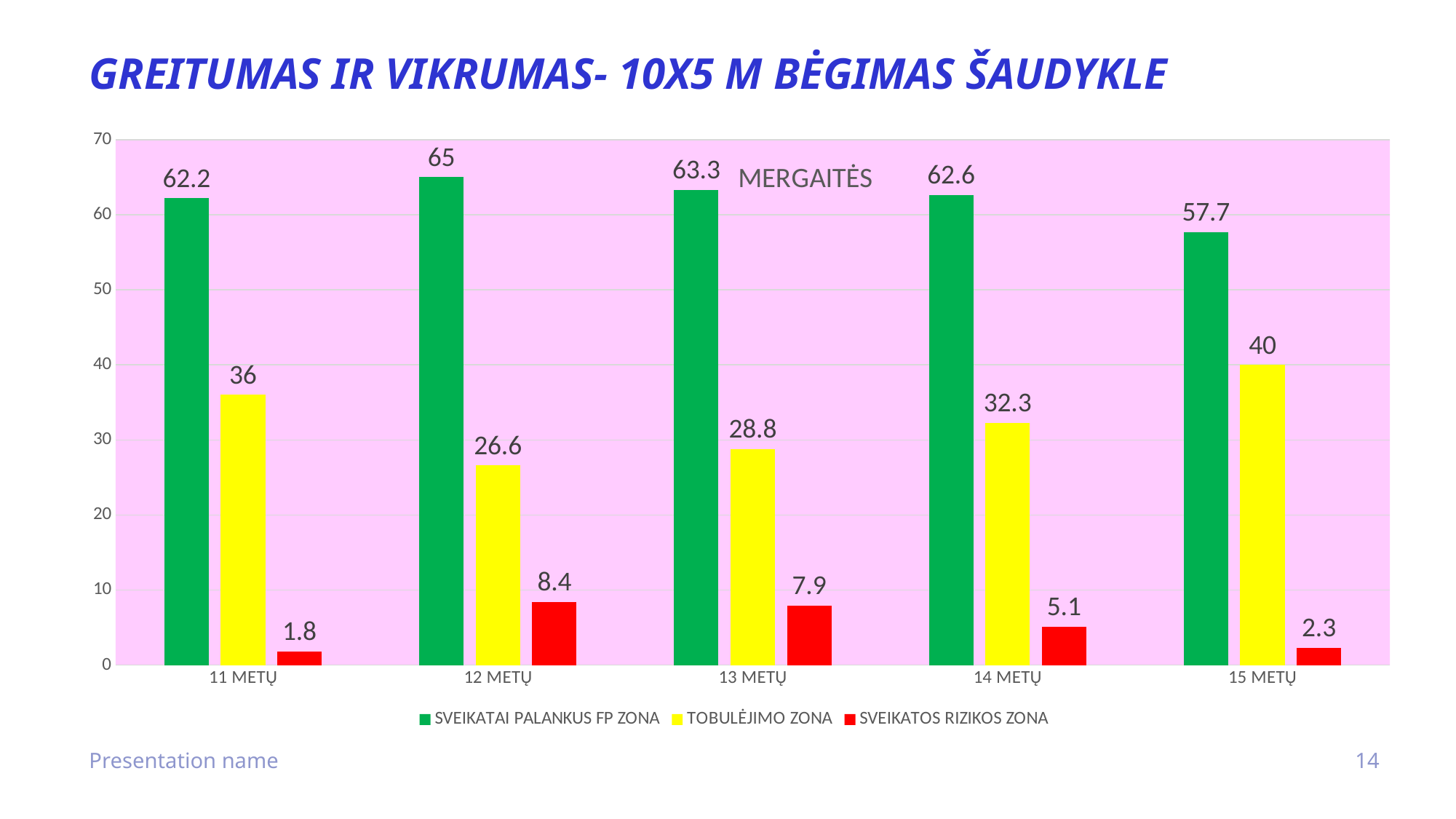
How many age groups are shown on the x axis? 5 Is the value of SVEIKATAI PALANKUS FP ZONA for 15 METŲ greater or less than 60? less Which age group has the lowest value for TOBULĖJIMO ZONA? 12 METŲ What is the difference between the SVEIKATOS RIZIKOS ZONA values for 12 METŲ and 13 METŲ? 0.5 What colour represents SVEIKATOS RIZIKOS ZONA in the chart? red What is the value of SVEIKATAI PALANKUS FP ZONA for 12 METŲ? 65 What is the value of SVEIKATOS RIZIKOS ZONA for 11 METŲ? 1.8 How many series does the legend list? 3 What is the value of TOBULĖJIMO ZONA for 14 METŲ? 32.3 What kind of chart is shown on the slide? bar chart Which age group has the highest value for SVEIKATAI PALANKUS FP ZONA? 12 METŲ Which is larger: TOBULĖJIMO ZONA for 11 METŲ or for 15 METŲ? 15 METŲ